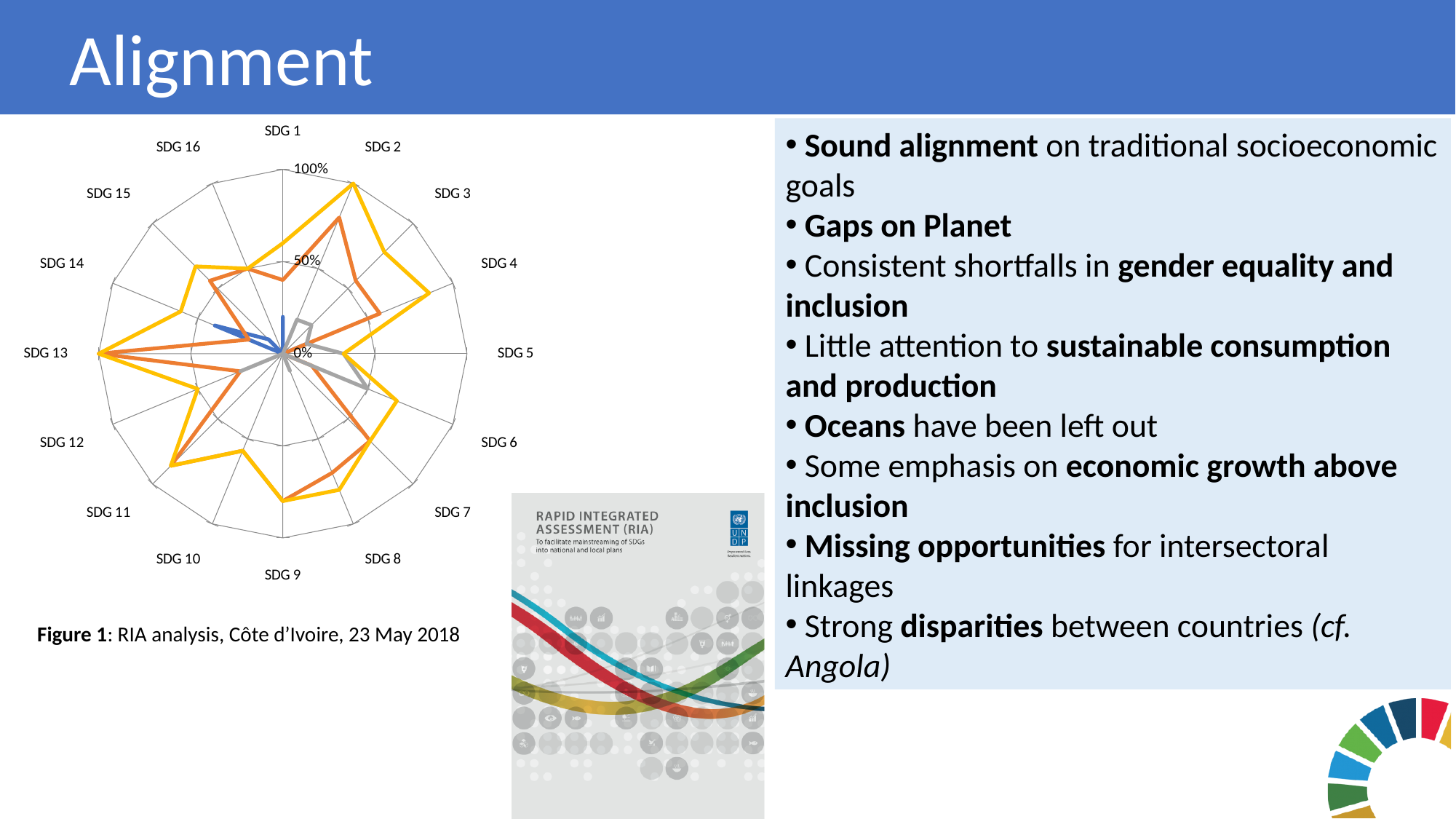
Is the yellow series value for SDG 9 greater or less than 50%? greater What is the highest percentage tick shown on the radar chart's axis? 100% Is the gray series value for SDG 5 greater or less than 50%? less Which SDG has the highest value on the yellow series of the radar chart? SDG 2 and SDG 13 What type of chart is shown in Figure 1? Radar chart Is the blue series value for SDG 1 greater or less than 50%? less According to the caption, which country does the RIA analysis in Figure 1 cover? Côte d'Ivoire At SDG 2, which series has the larger value, the yellow or the orange? Yellow How many SDG categories are plotted around the radar chart? 16 Which SDG has the highest value on the orange series of the radar chart? SDG 13